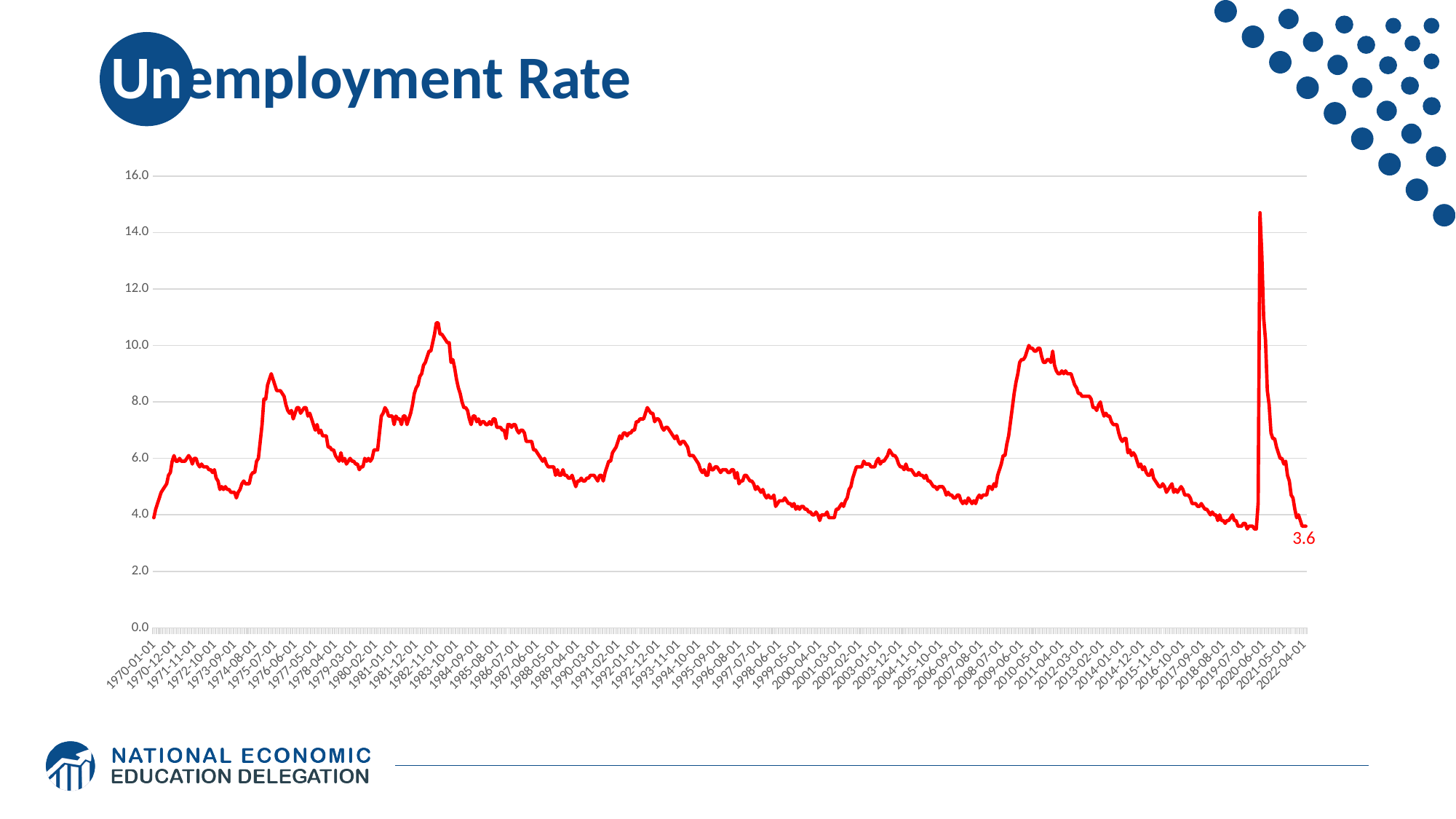
What is the last date label shown on the x axis? 2022-04-01 What value is printed as the data label at the end of the line? 3.6 What kind of chart is shown on the slide? line chart In which year does the line reach its highest point? 2020 Is the peak value around 1982-1983 greater or less than 10.0? greater Between 2010 and 2019, does the unemployment rate generally rise or fall? fall Is the peak value around 2009-2010 greater or less than 12.0? less What is the title of the chart? Unemployment Rate After the 2020 spike, does the line rise or fall through 2022? fall What is the highest tick value shown on the y axis? 16.0 Is the peak value around 1975 greater or less than 8.0? greater